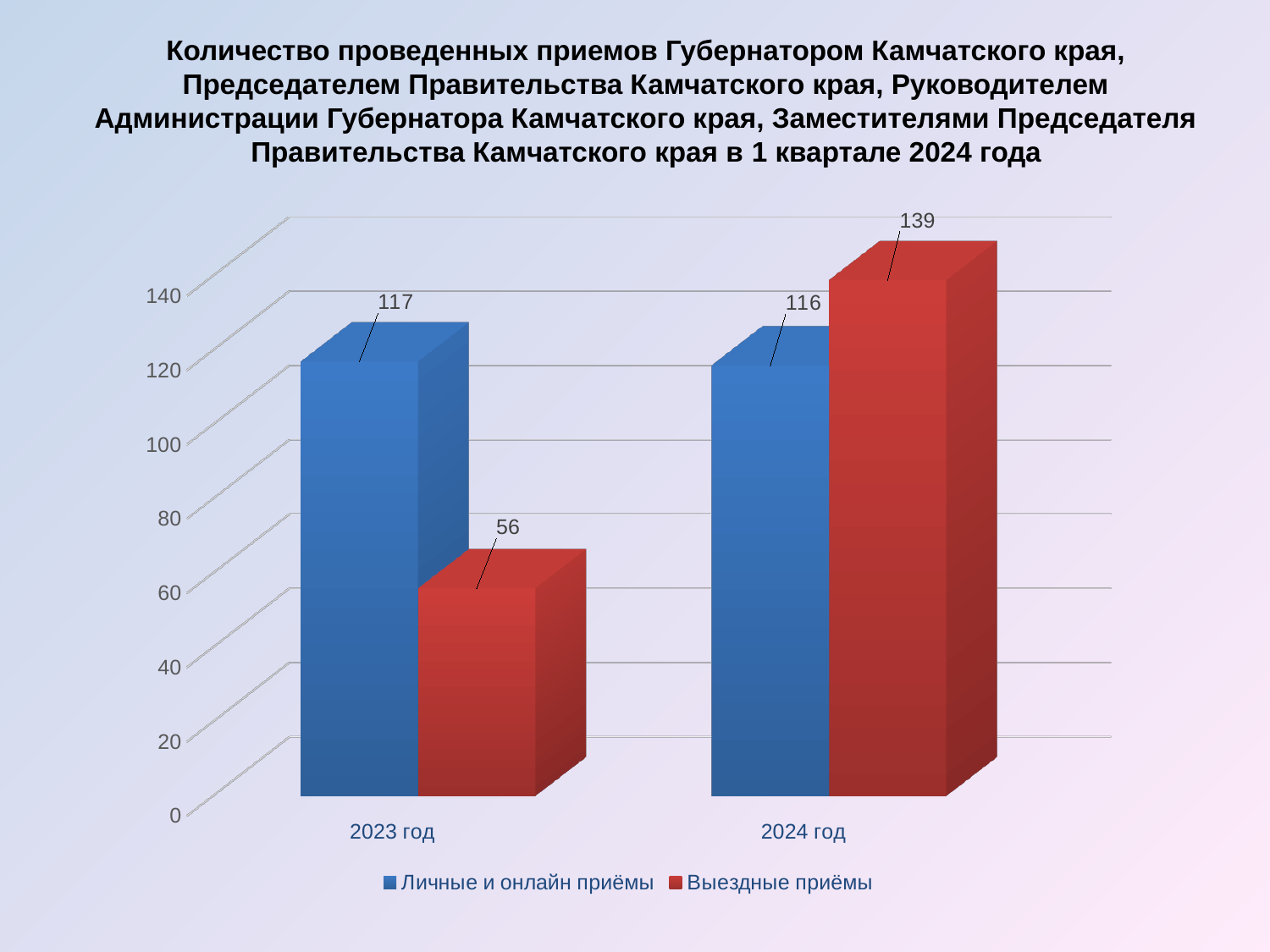
How many categories are shown on the x axis? 2 What is the value for Выездные приёмы in 2024 год? 139 What kind of chart is shown on the slide? Bar chart What is the value for Личные и онлайн приёмы in 2024 год? 116 Which is larger in 2023 год: Личные и онлайн приёмы or Выездные приёмы? Личные и онлайн приёмы How many series does the legend list? 2 What is the value for Личные и онлайн приёмы in 2023 год? 117 Which bar has the highest value on the chart? Выездные приёмы, 2024 год What is the value for Выездные приёмы in 2023 год? 56 What is the difference between Выездные приёмы in 2024 год and in 2023 год? 83 Which colour represents Выездные приёмы in the legend? Red Which bar has the lowest value on the chart? Выездные приёмы, 2023 год